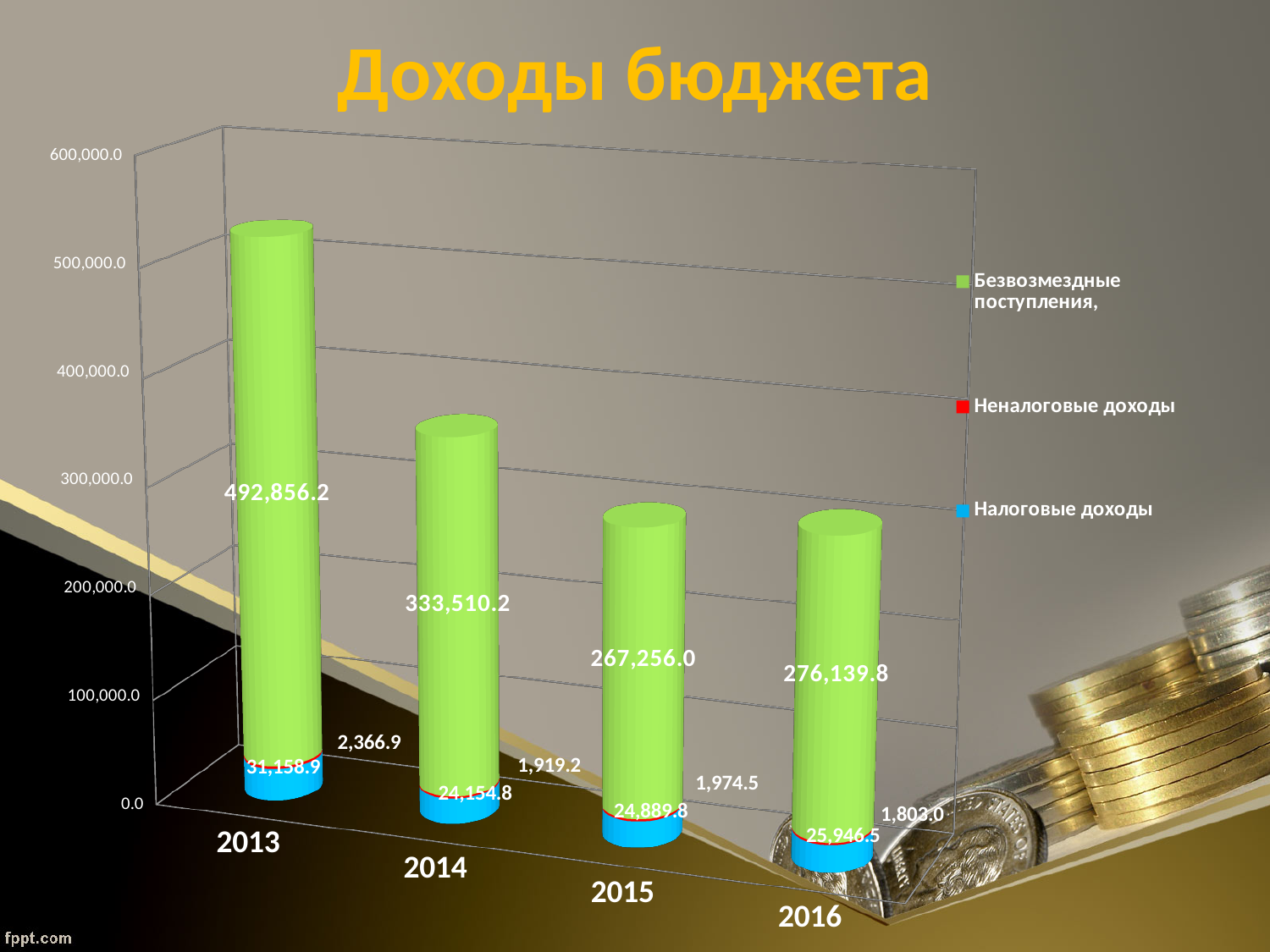
What is the value of Налоговые доходы for 2016? 25,946.5 What kind of chart is shown on the slide? Bar chart How many series does the legend list? 3 How many years are shown on the x axis? 4 What is the total of the stacked bar for 2013? 526,382.0 In which year is Неналоговые доходы the lowest? 2016 What is the difference between Безвозмездные поступления in 2013 and 2014? 159,346.0 What is the value of Безвозмездные поступления for 2013? 492,856.2 In which year is Безвозмездные поступления the lowest? 2015 What is the value of Неналоговые доходы for 2014? 1,919.2 Which year has the larger value of Безвозмездные поступления, 2015 or 2016? 2016 In which year is Безвозмездные поступления the highest? 2013